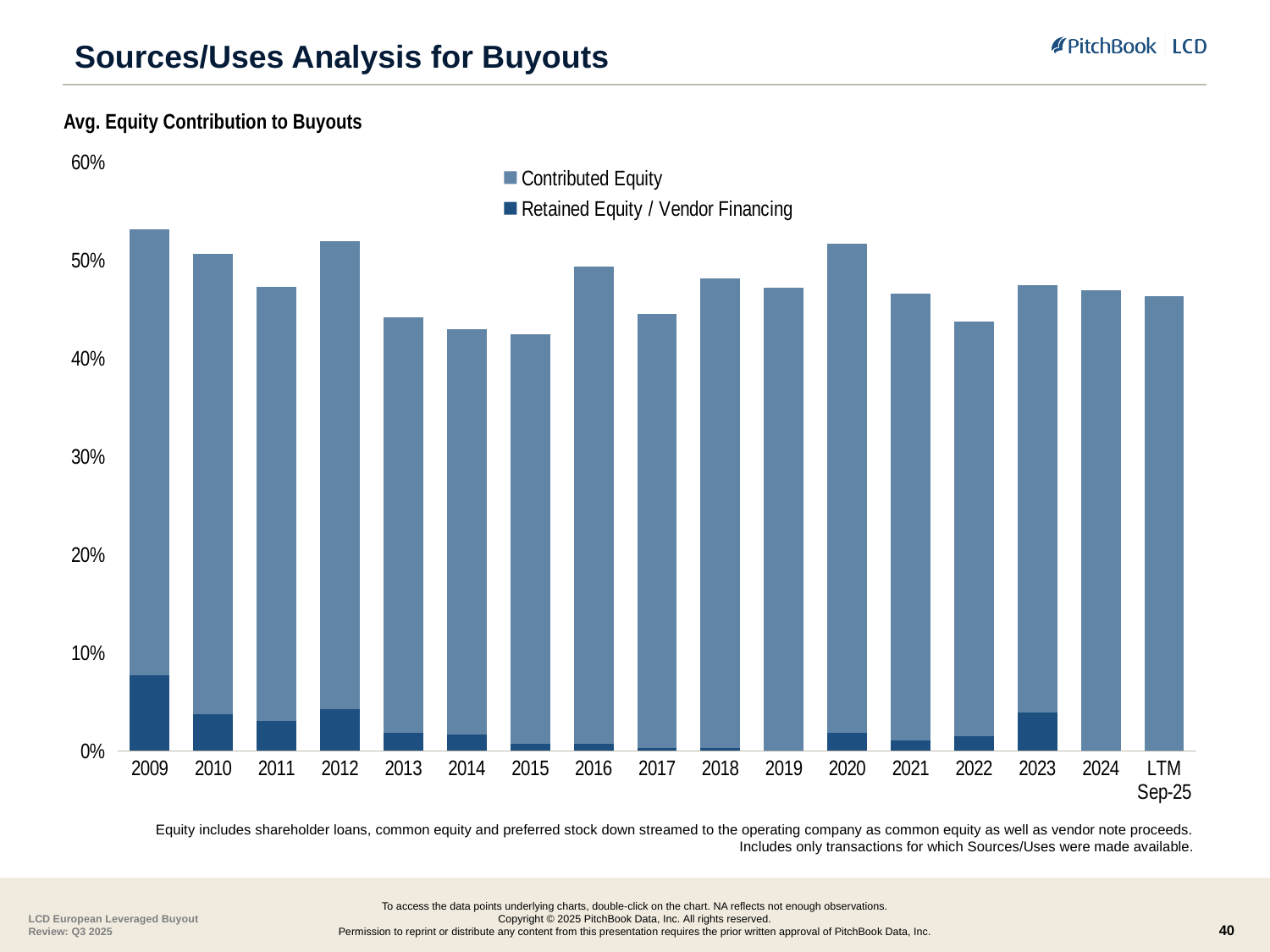
Is the total bar height for 2015 greater or less than 50%? less Is the total bar height for 2009 greater or less than 50%? greater Is the total bar height for 2020 greater or less than 50%? greater Do the total bar heights rise or fall from 2012 to 2015? fall Which has the taller total bar, 2016 or 2013? 2016 How many categories are shown along the x axis? 17 What is the title of the chart? Avg. Equity Contribution to Buyouts What kind of chart is shown on the slide? Bar chart Which series is shown in the darker blue at the bottom of the bars? Retained Equity / Vendor Financing Which year has the largest Retained Equity / Vendor Financing segment? 2009 How many series does the legend list? 2